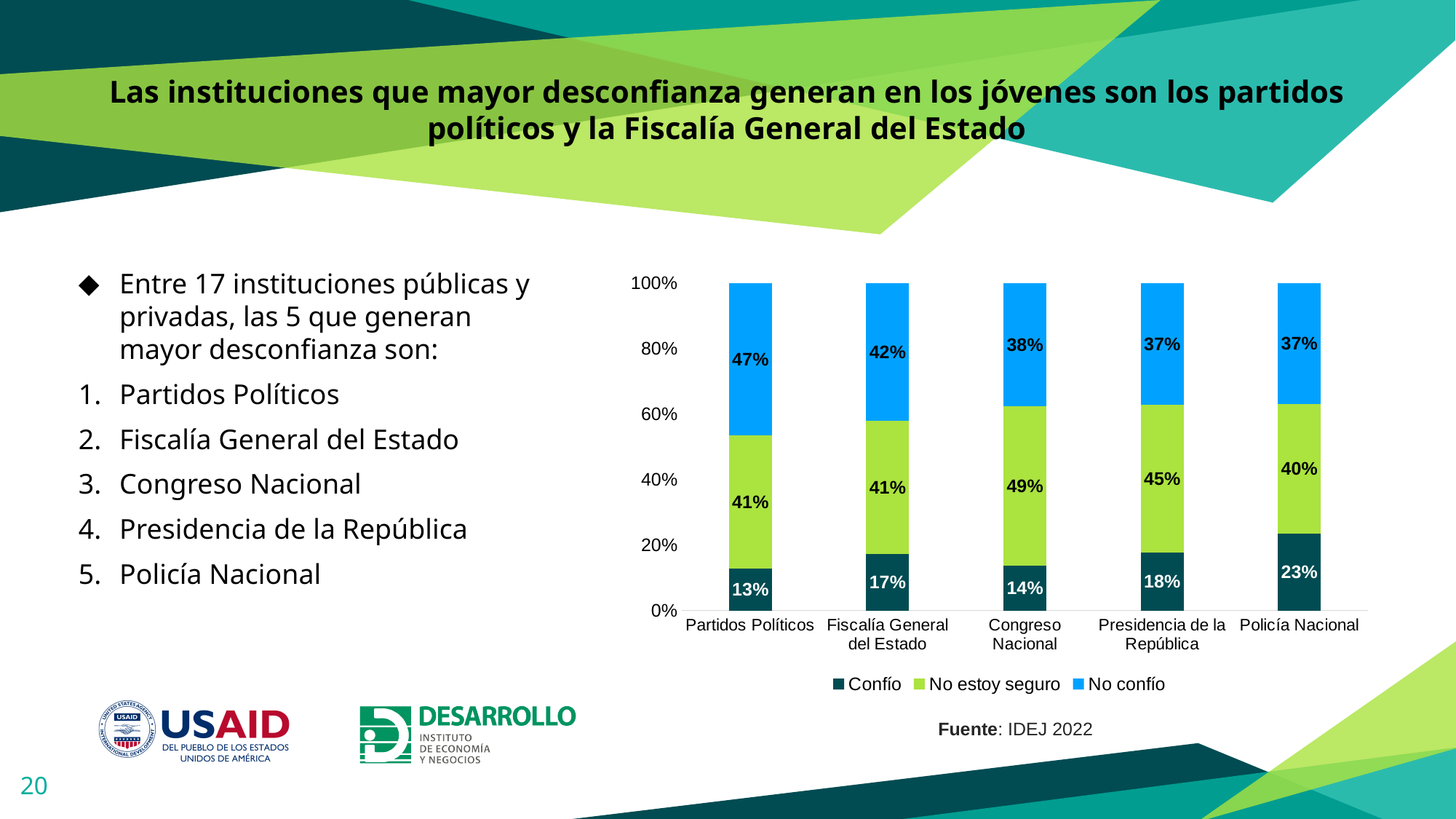
What is the difference between the 'No confío' values for Partidos Políticos and Fiscalía General del Estado? 5% Which institution has the highest 'No confío' value? Partidos Políticos What is the 'No estoy seguro' value for Congreso Nacional? 49% Do the 'No confío' values rise or fall from Partidos Políticos to Policía Nacional? Fall What kind of chart is shown? Stacked bar chart What is the 'No confío' value for Partidos Políticos? 47% Which is larger: the 'Confío' value for Presidencia de la República or for Congreso Nacional? Presidencia de la República How many institutions are shown on the x axis? 5 How many series does the legend list? 3 Which institution has the lowest 'Confío' value? Partidos Políticos Which series is shown in light green in the legend? No estoy seguro What is the 'Confío' value for Policía Nacional? 23%